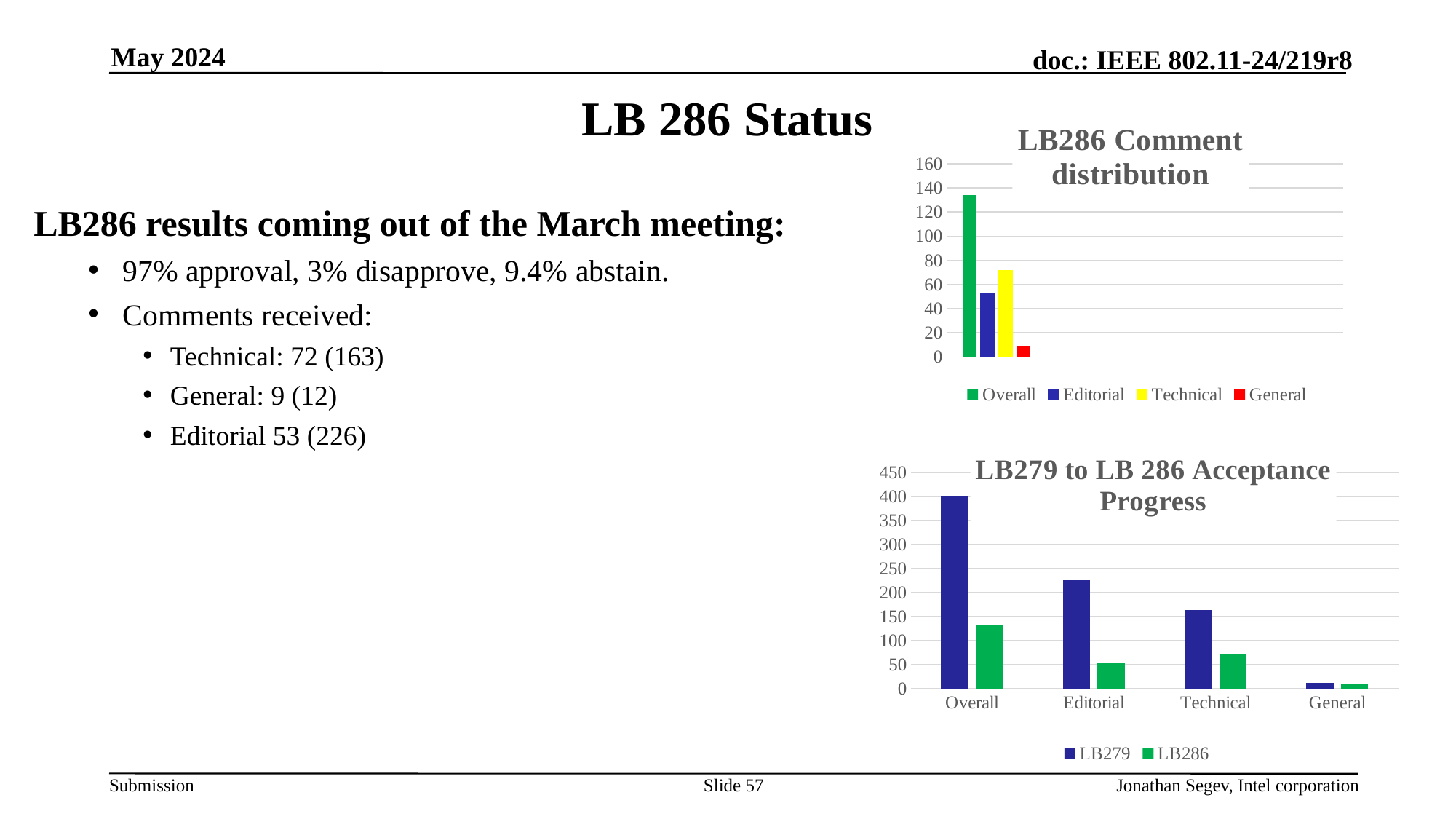
How many entries does the legend of the LB286 Comment distribution chart list? 4 In the LB286 Comment distribution chart, is the value for Technical greater or less than 60? greater In the LB279 to LB 286 Acceptance Progress chart, is the LB279 value for Overall greater or less than 350? greater In the LB279 to LB 286 Acceptance Progress chart, is the LB279 value for Editorial greater or less than 200? greater In the LB286 Comment distribution chart, which category has the lowest bar? General In the LB286 Comment distribution chart, which category has the highest bar? Overall In the LB279 to LB 286 Acceptance Progress chart, which series has the higher bar for Technical, LB279 or LB286? LB279 How many categories are shown on the x axis of the LB279 to LB 286 Acceptance Progress chart? 4 In the LB286 Comment distribution chart, which is larger, Editorial or Technical? Technical What kind of chart is the LB279 to LB 286 Acceptance Progress chart? bar chart In the LB279 to LB 286 Acceptance Progress chart, what colour are the LB286 bars? green